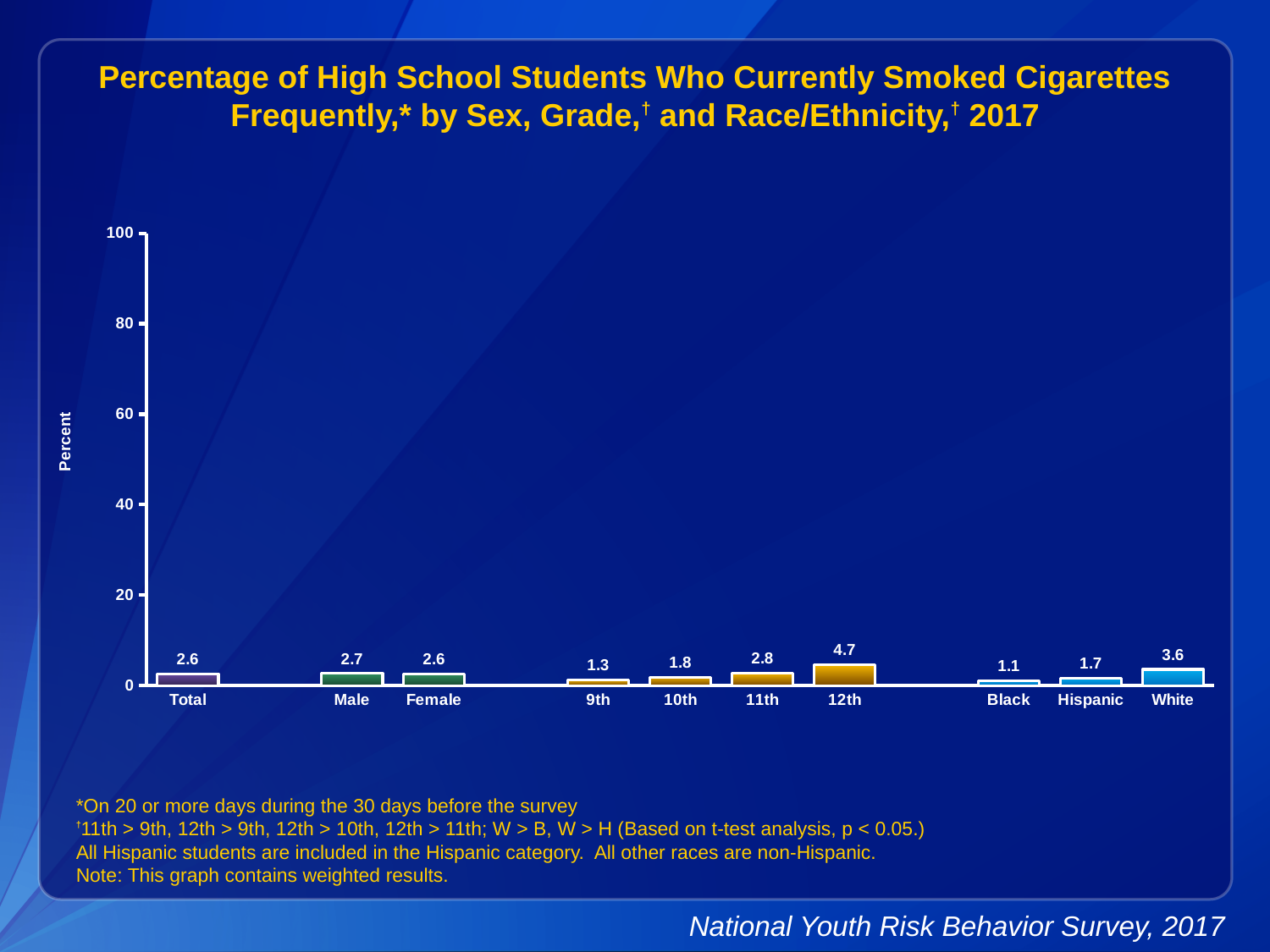
What is the value for Male students? 2.7 How many categories are shown on the x axis? 10 What is the value for the Total category? 2.6 What is the value for Black students? 1.1 What is the difference between the values for 12th and 9th grade students? 3.4 Which category has the highest value? 12th What is the difference between the values for White and Black students? 2.5 Which category has the lowest value? Black What is the label on the y axis? Percent Which is larger, the value for Hispanic students or the value for White students? White What is the value for 12th grade students? 4.7 What kind of chart is shown on the slide? Bar chart